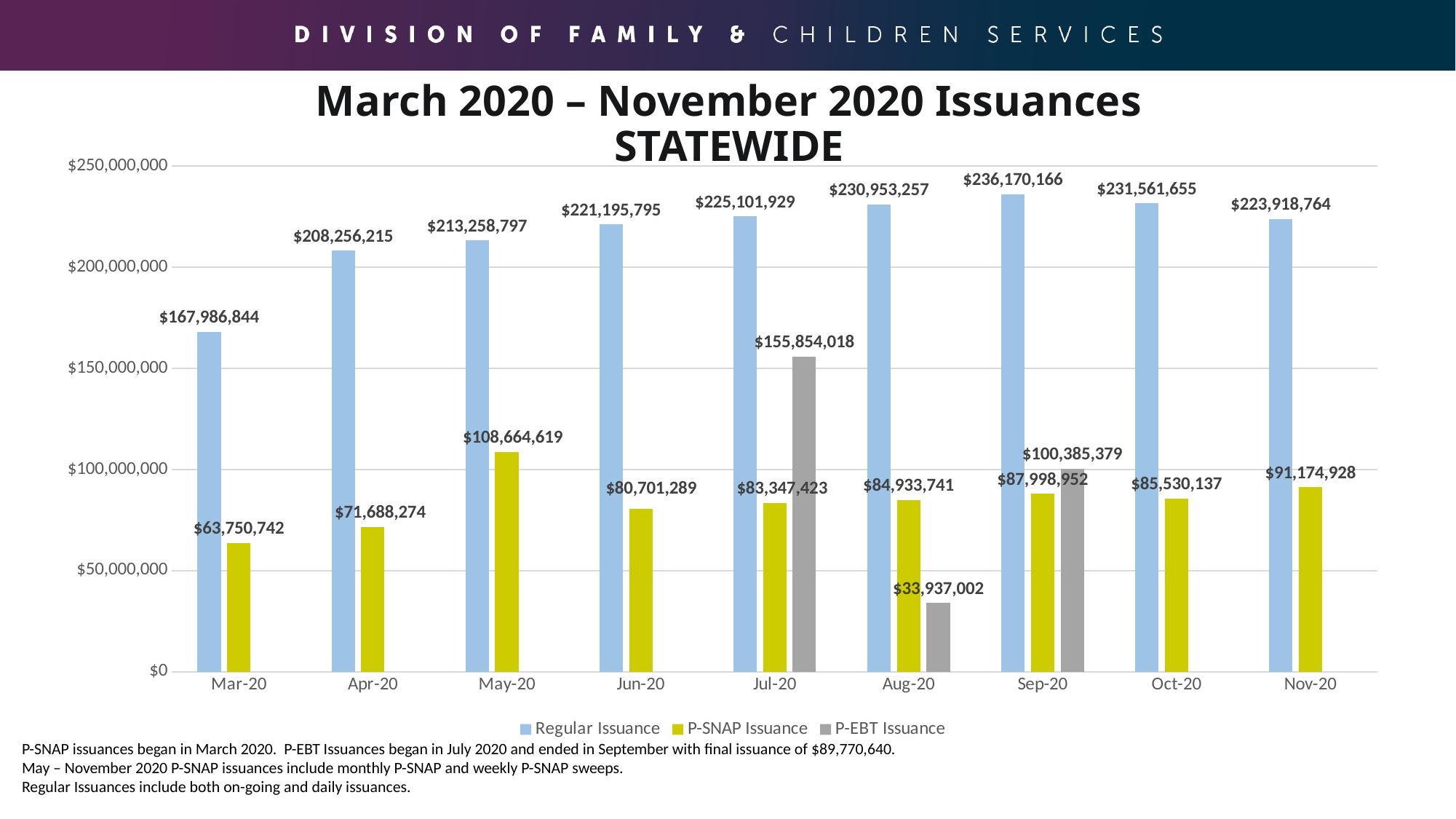
What kind of chart is shown on the slide? Bar chart How many series does the legend list? 3 In Sep-20, which is larger: the P-EBT Issuance or the P-SNAP Issuance? P-EBT Issuance What is the Regular Issuance value for Mar-20? $167,986,844 How many months are shown on the x axis? 9 What is the P-EBT Issuance value for Aug-20? $33,937,002 Does the Regular Issuance rise or fall from Mar-20 to Sep-20? Rises Which month has the lowest P-SNAP Issuance? Mar-20 What is the P-EBT Issuance value for Jul-20? $155,854,018 Which month has the highest Regular Issuance? Sep-20 What is the difference between the Regular Issuance for Sep-20 and Aug-20? $5,216,909 What is the P-SNAP Issuance value for May-20? $108,664,619